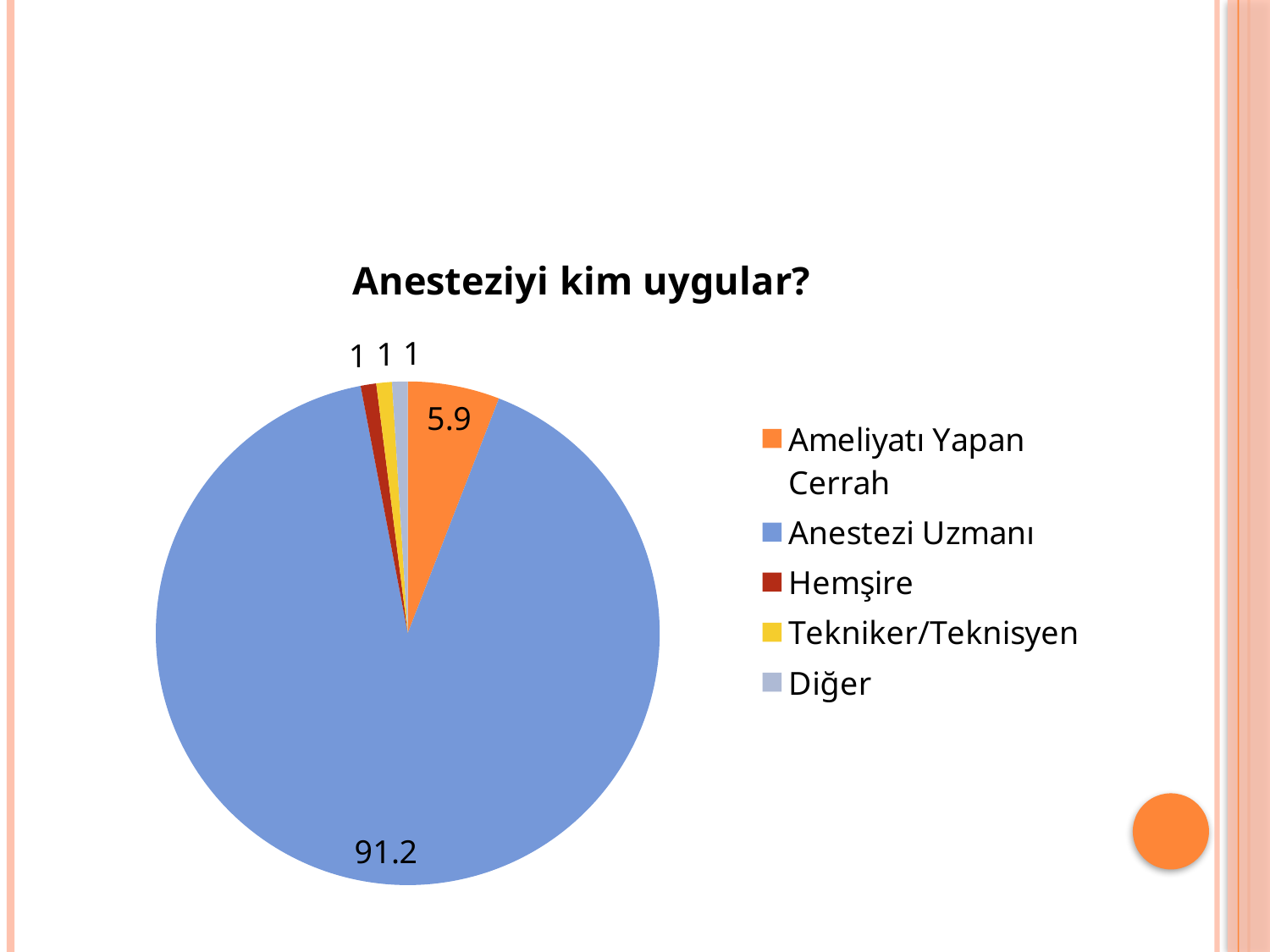
How many categories does the legend list? 5 What colour is the slice for Anestezi Uzmanı? blue Which category has the largest slice of the pie? Anestezi Uzmanı What is the title of the chart? Anesteziyi kim uygular? What type of chart is shown on the slide? pie chart What is the value for Tekniker/Teknisyen? 1 What is the difference between the values for Anestezi Uzmanı and Ameliyatı Yapan Cerrah? 85.3 Which is larger, the value for Ameliyatı Yapan Cerrah or the value for Hemşire? Ameliyatı Yapan Cerrah What is the value for Hemşire? 1 What is the value for Anestezi Uzmanı? 91.2 What is the value for Ameliyatı Yapan Cerrah? 5.9 What is the value for Diğer? 1